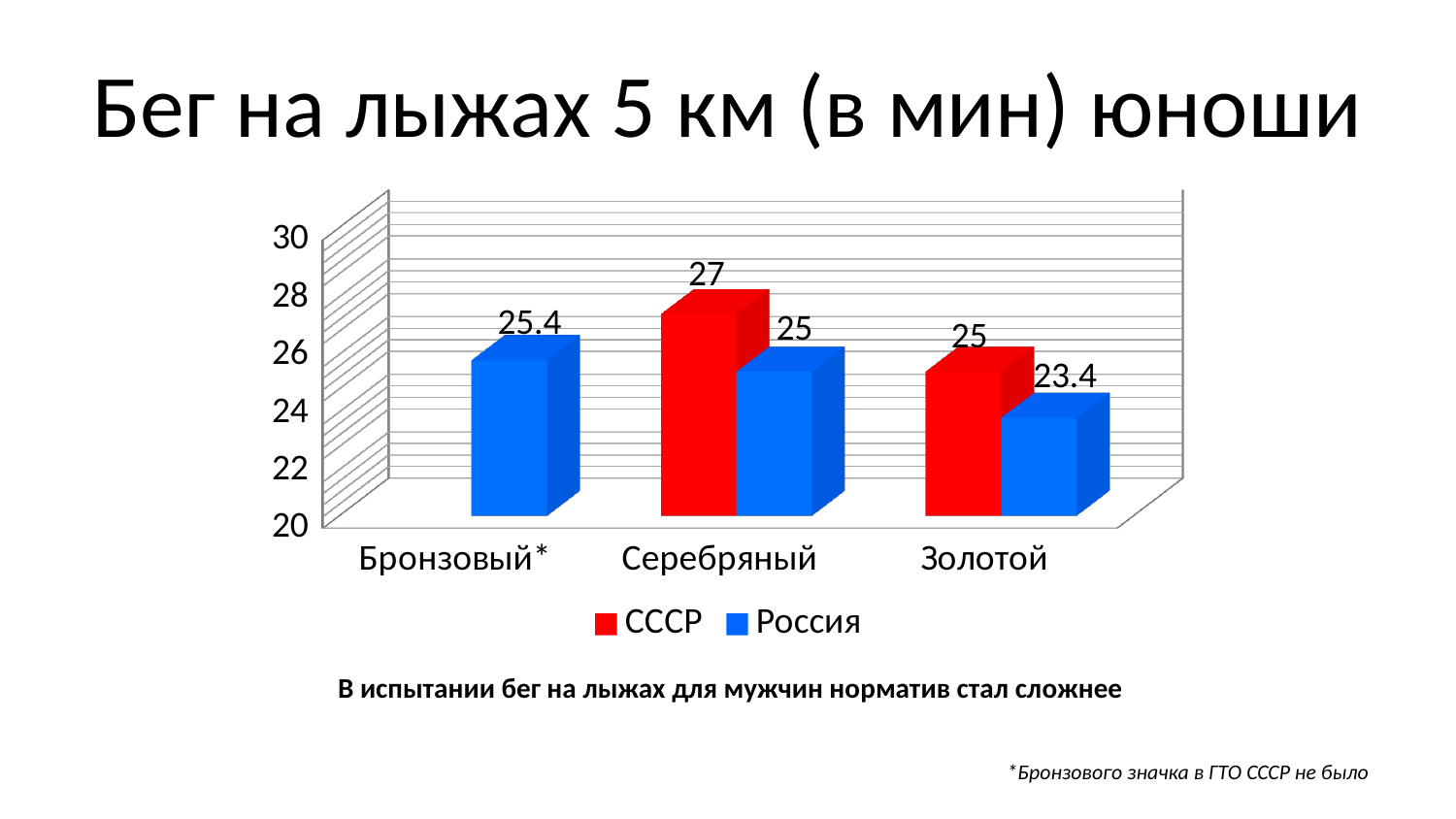
In the Золотой category, which series has the larger value, СССР or Россия? СССР Which category has the highest value for the СССР series? Серебряный What is the value for Россия in the Бронзовый category? 25.4 What is the value for СССР in the Золотой category? 25 What is the difference between the Россия values for Бронзовый and Золотой? 2 What kind of chart is shown on the slide? Bar chart What is the value for Россия in the Золотой category? 23.4 Which category has the lowest value for the Россия series? Золотой What is the value for Россия in the Серебряный category? 25 What is the difference between the СССР and Россия values in the Серебряный category? 2 How many series does the legend list? 2 Which colour represents the Россия series? Blue